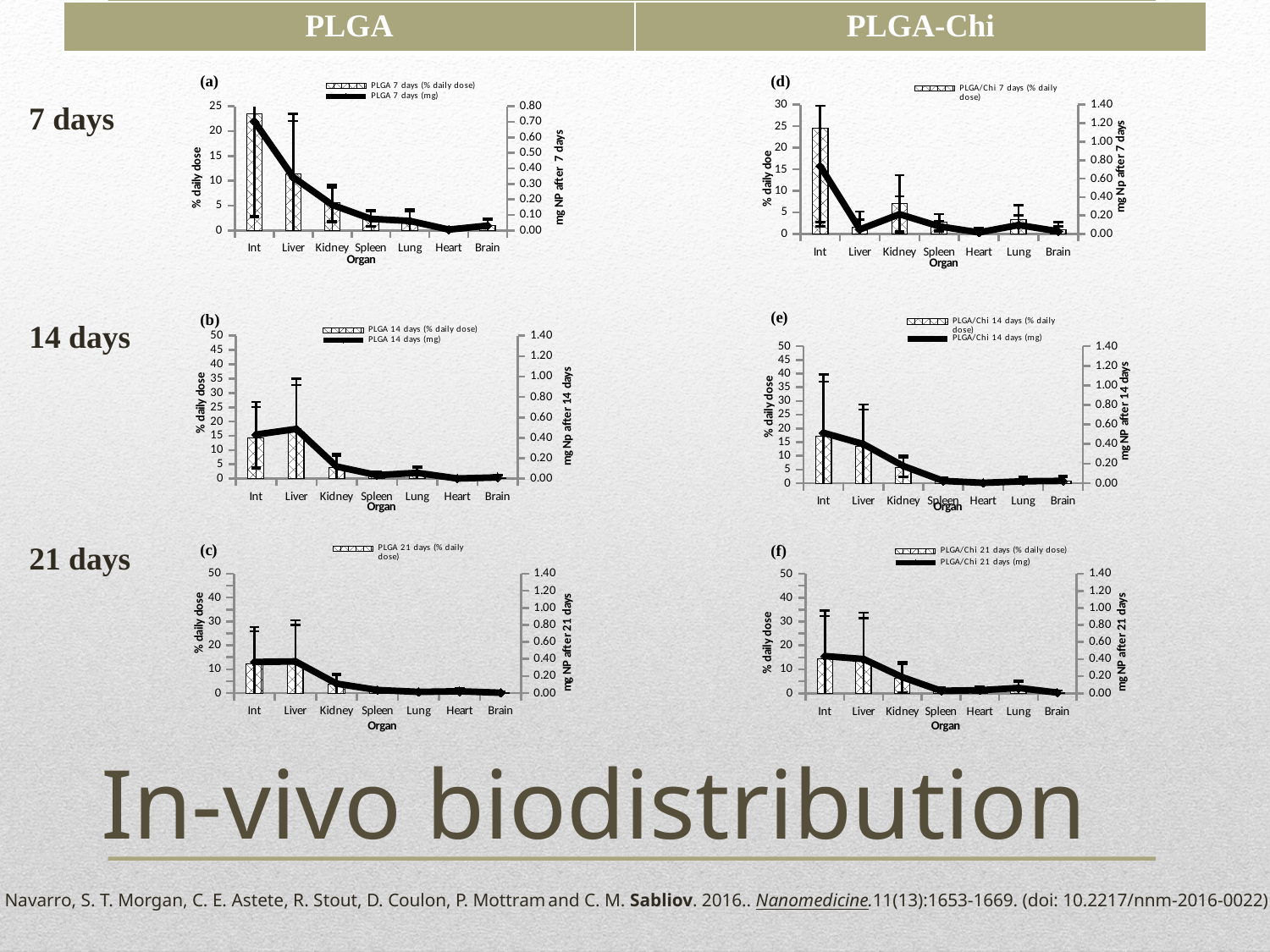
In chart (d), which organ has the highest % daily dose? Int In chart (a), what is the x-axis title? Organ In chart (a), how many organs are shown on the x axis? 7 In chart (a), which organ has the highest % daily dose? Int In chart (a), how many series does the legend list? 2 In chart (d), which is larger, the % daily dose for Kidney or for Liver? Kidney In chart (a), is the % daily dose for Int greater or less than 20? greater In chart (c), is the mg NP after 21 days for Int greater or less than 0.60? less In chart (b), is the % daily dose for Int greater or less than 10? greater In chart (a), does the mg NP line rise or fall from Int to Brain? fall In chart (a), which is larger, the % daily dose for Int or for Liver? Int